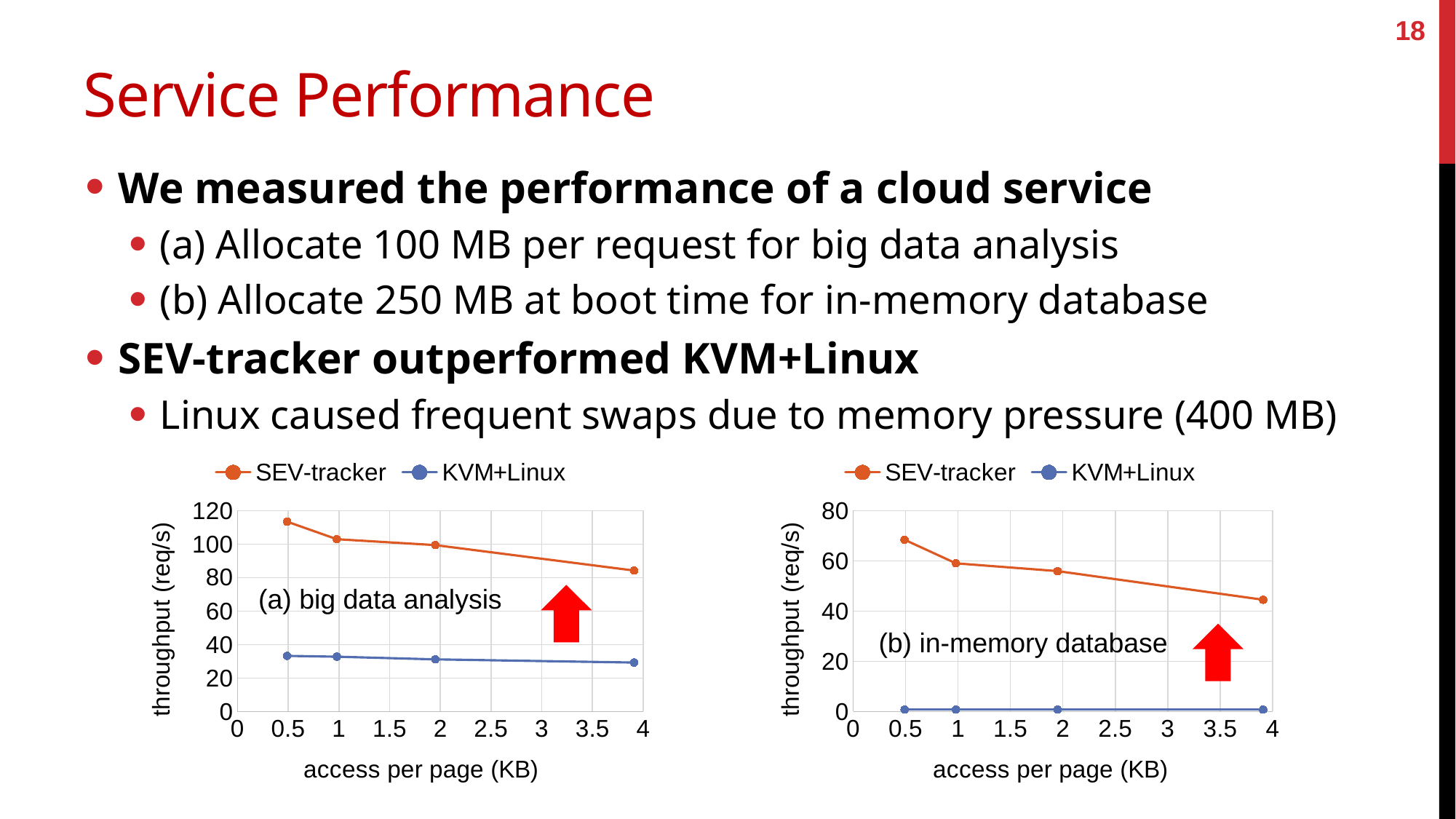
In the '(a) big data analysis' chart, does the SEV-tracker throughput rise or fall as access per page increases? fall How many series does the legend of the '(b) in-memory database' chart list? 2 In the '(a) big data analysis' chart, is the KVM+Linux throughput at 4 KB access per page greater or less than 40? less In the '(b) in-memory database' chart, is the SEV-tracker throughput at 4 KB access per page greater or less than 60? less What is the y-axis label of the '(b) in-memory database' chart? throughput (req/s) In the '(a) big data analysis' chart, which series has the higher throughput at 2 KB access per page, SEV-tracker or KVM+Linux? SEV-tracker In the '(a) big data analysis' chart, how many data points are plotted for the SEV-tracker series? 4 In the '(b) in-memory database' chart, which series has the lower throughput, SEV-tracker or KVM+Linux? KVM+Linux In the '(a) big data analysis' chart, is the SEV-tracker throughput at 0.5 KB access per page greater or less than 100? greater What is the x-axis label of the '(a) big data analysis' chart? access per page (KB) In the '(b) in-memory database' chart, does the SEV-tracker throughput rise or fall as access per page increases? fall What kind of chart is the '(a) big data analysis' chart on the left? line chart